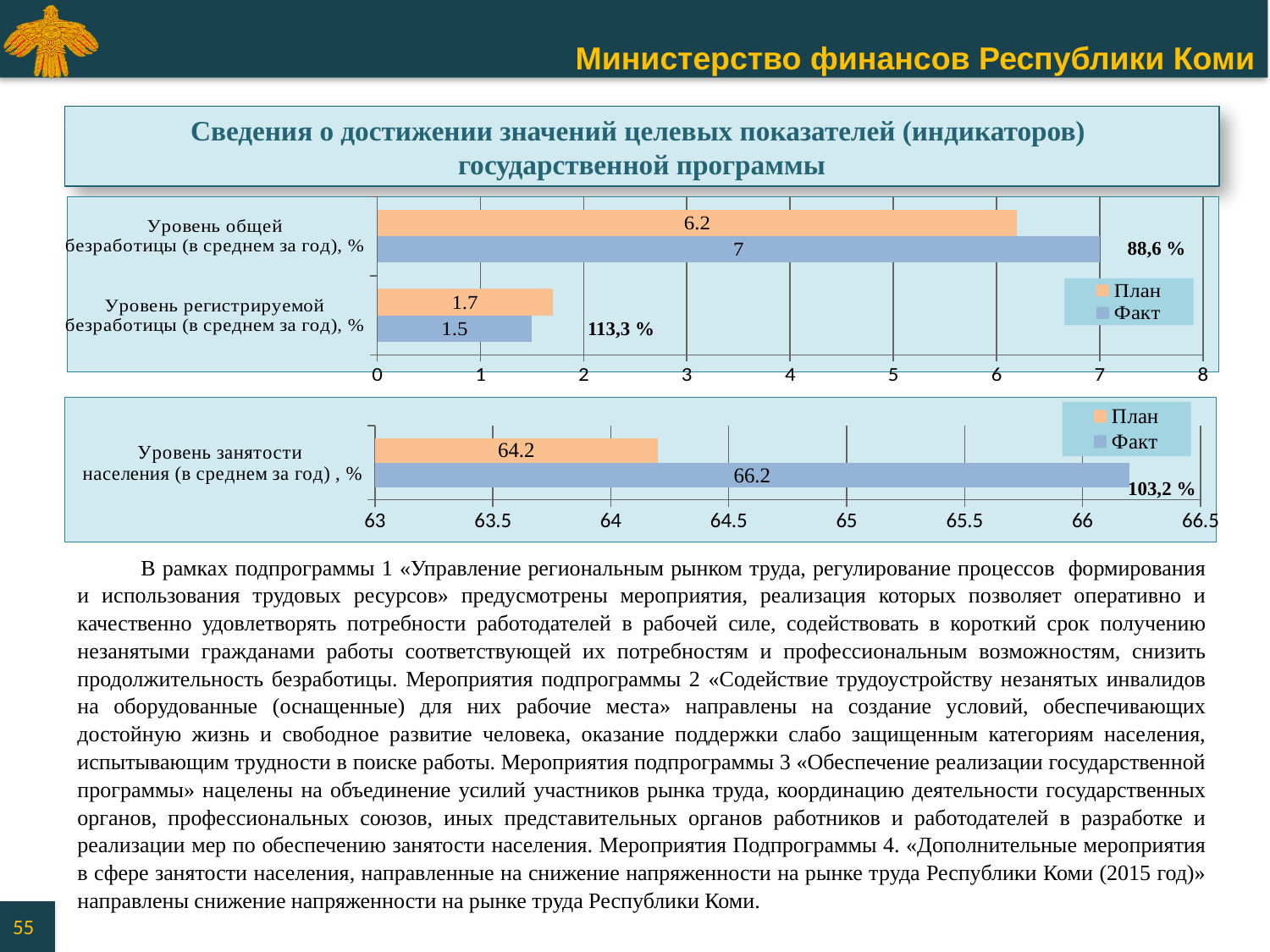
In the bottom chart, which colour represents the Факт series? Blue In the top chart, how many categories are shown? 2 In the top chart, what is the План value for Уровень общей безработицы (в среднем за год), %? 6.2 In the top chart, what is the difference between the Факт and План values for Уровень общей безработицы? 0.8 In the top chart, how many series does the legend list? 2 In the bottom chart, what is the План value for Уровень занятости населения (в среднем за год), %? 64.2 In the top chart, what is the Факт value for Уровень регистрируемой безработицы (в среднем за год), %? 1.5 In the bottom chart, what is the Факт value for Уровень занятости населения (в среднем за год), %? 66.2 What kind of chart is the top chart? Bar chart In the top chart, what is the Факт value for Уровень общей безработицы (в среднем за год), %? 7 In the bottom chart, what is the difference between the Факт and План values for Уровень занятости населения? 2 In the top chart, which is larger for Уровень регистрируемой безработицы: План or Факт? План